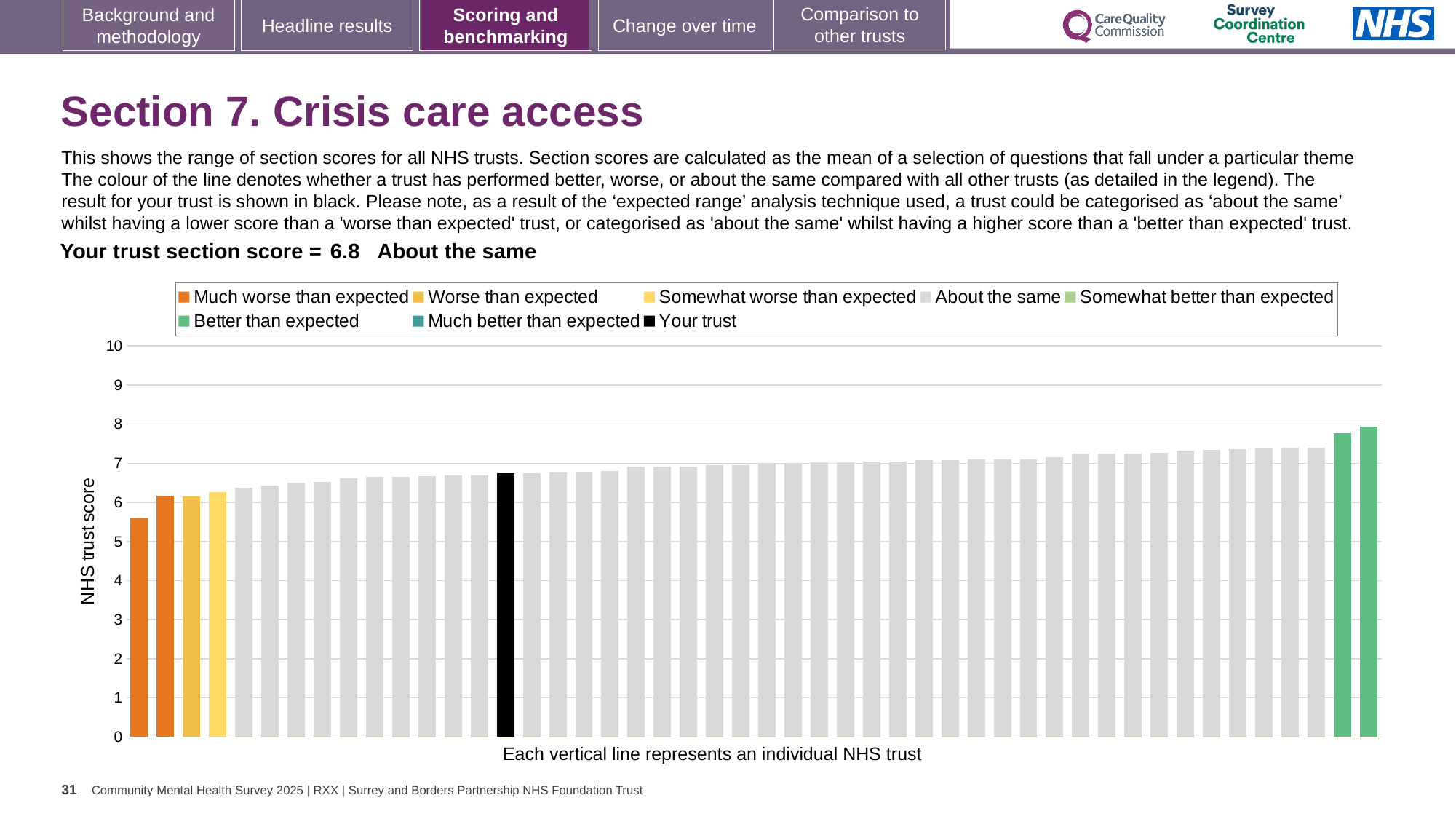
How many bars are coloured orange (much worse than expected)? 2 Is the value for the lowest-scoring trust (the leftmost bar) greater or less than 6? less Which category is your trust placed in for this section? About the same What colour is the bar representing your trust? Black Is the value for your trust (the black bar) greater or less than 6? greater What is the section score for your trust shown on the slide? 6.8 What kind of chart is shown on the slide? Bar chart Do the trust scores rise or fall moving from left to right along the x axis? Rise Is the value for the highest-scoring trust (the rightmost bar) greater or less than 7? greater What is the label on the vertical axis of the chart? NHS trust score How many entries does the chart legend list? 8 Is the bar for your trust higher or lower than the rightmost green bar? Lower